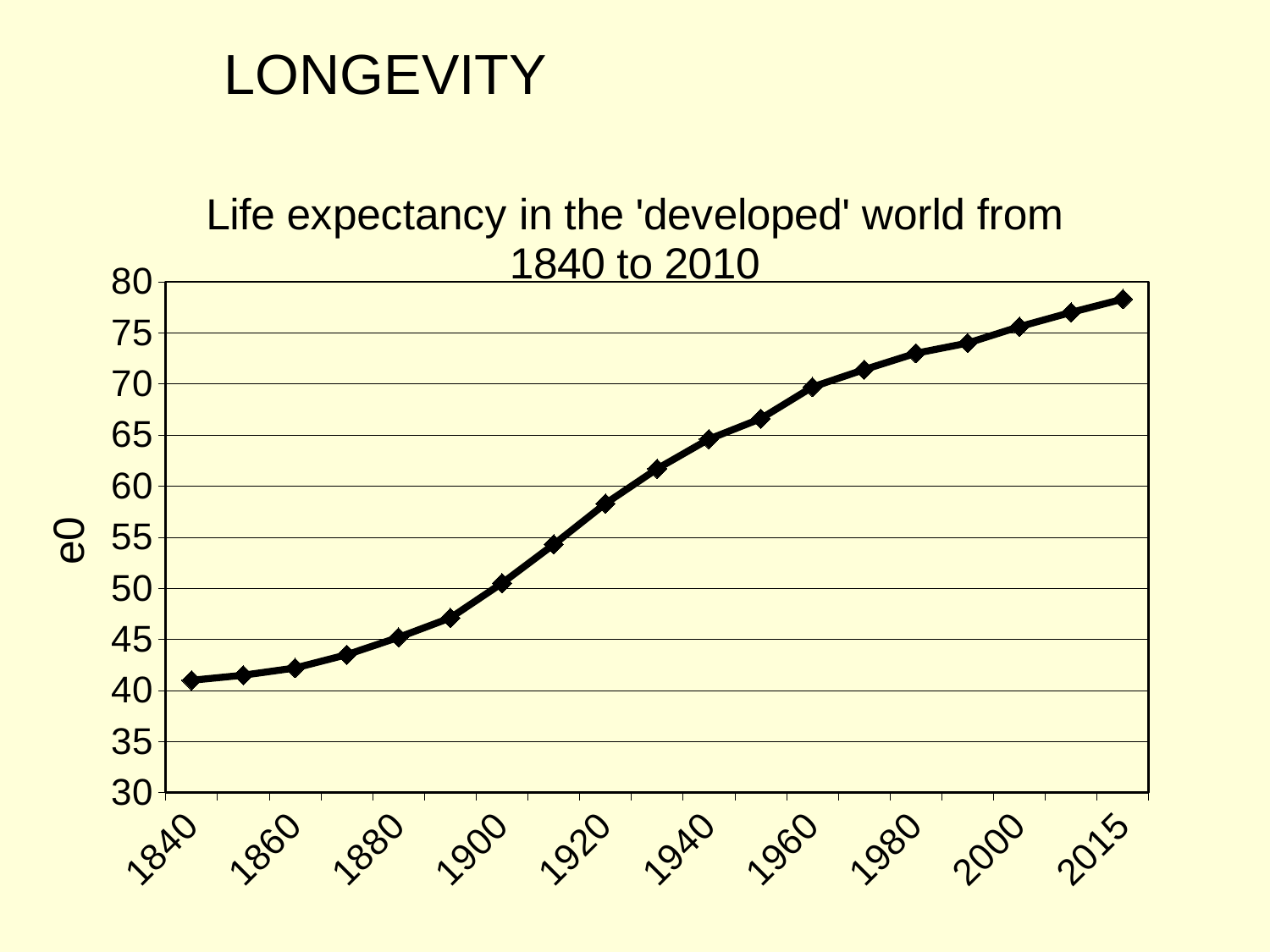
What is the title of the chart? Life expectancy in the 'developed' world from 1840 to 2010 Is the value for 1860 greater or less than 45? less Which year has the larger value, 1900 or 2000? 2000 Is the value for 1840 greater or less than 45? less What is the label on the vertical axis of the chart? e0 Which year has the lowest life expectancy value on the chart? 1840 What kind of chart is shown on the slide? line chart Is the value for 1920 greater or less than 55? greater Do the values rise or fall as the years increase along the x axis? rise Which year has the highest life expectancy value on the chart? 2015